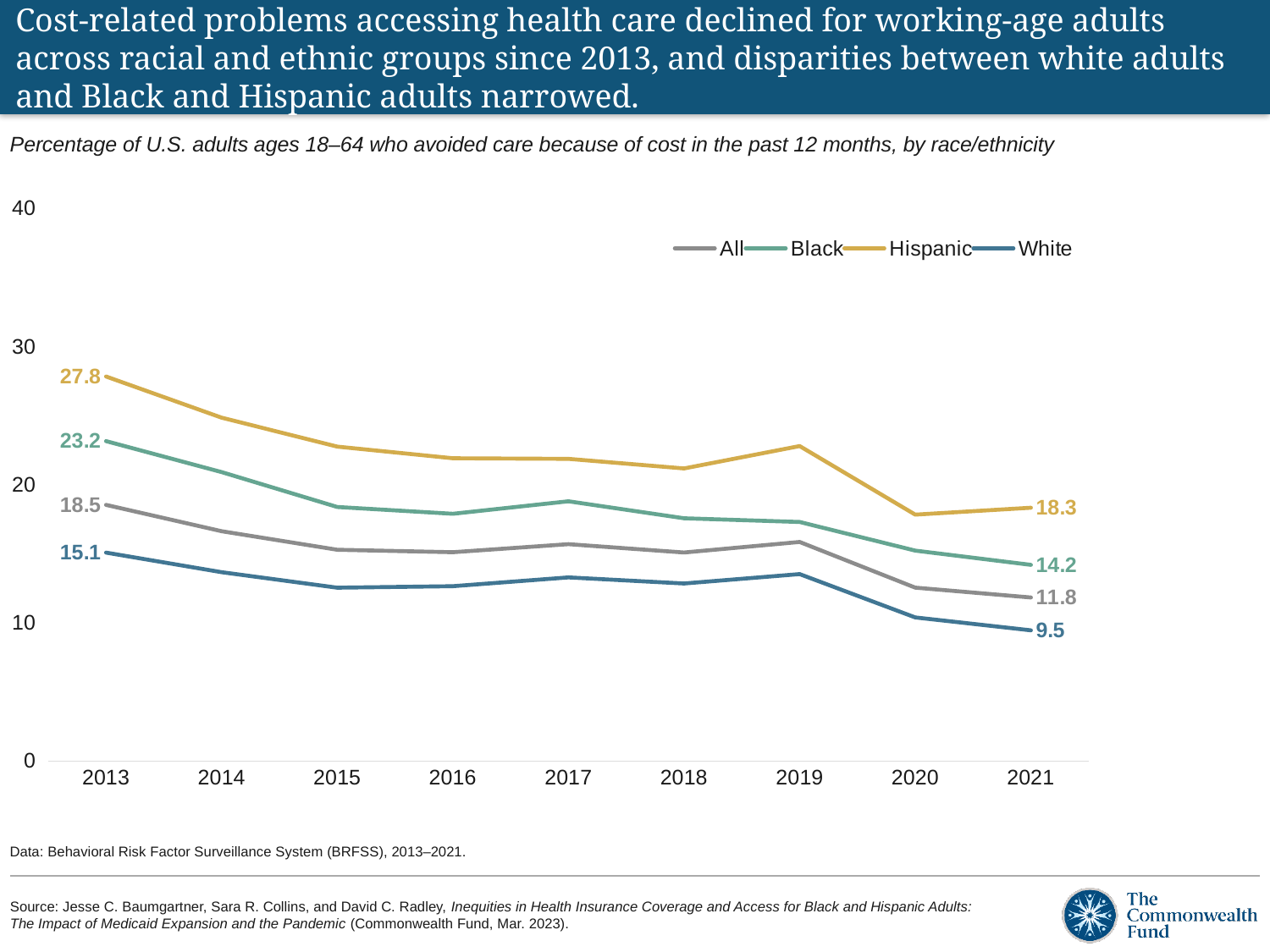
What was the value for All adults in 2013? 18.5 What kind of chart is shown on the slide? Line chart What is the difference between the Black and White values in 2021? 4.7 By how much did the value for Hispanic adults fall from 2013 to 2021? 9.5 Is the value for Hispanic adults in 2019 greater or less than 20? greater Which group had the highest value in 2021? Hispanic What was the value for White adults in 2021? 9.5 What was the value for Black adults in 2021? 14.2 In 2013, which was larger: the value for Black adults or the value for All adults? Black How many series does the legend list? 4 Which group had the lowest value in 2013? White What was the value for Hispanic adults in 2013? 27.8